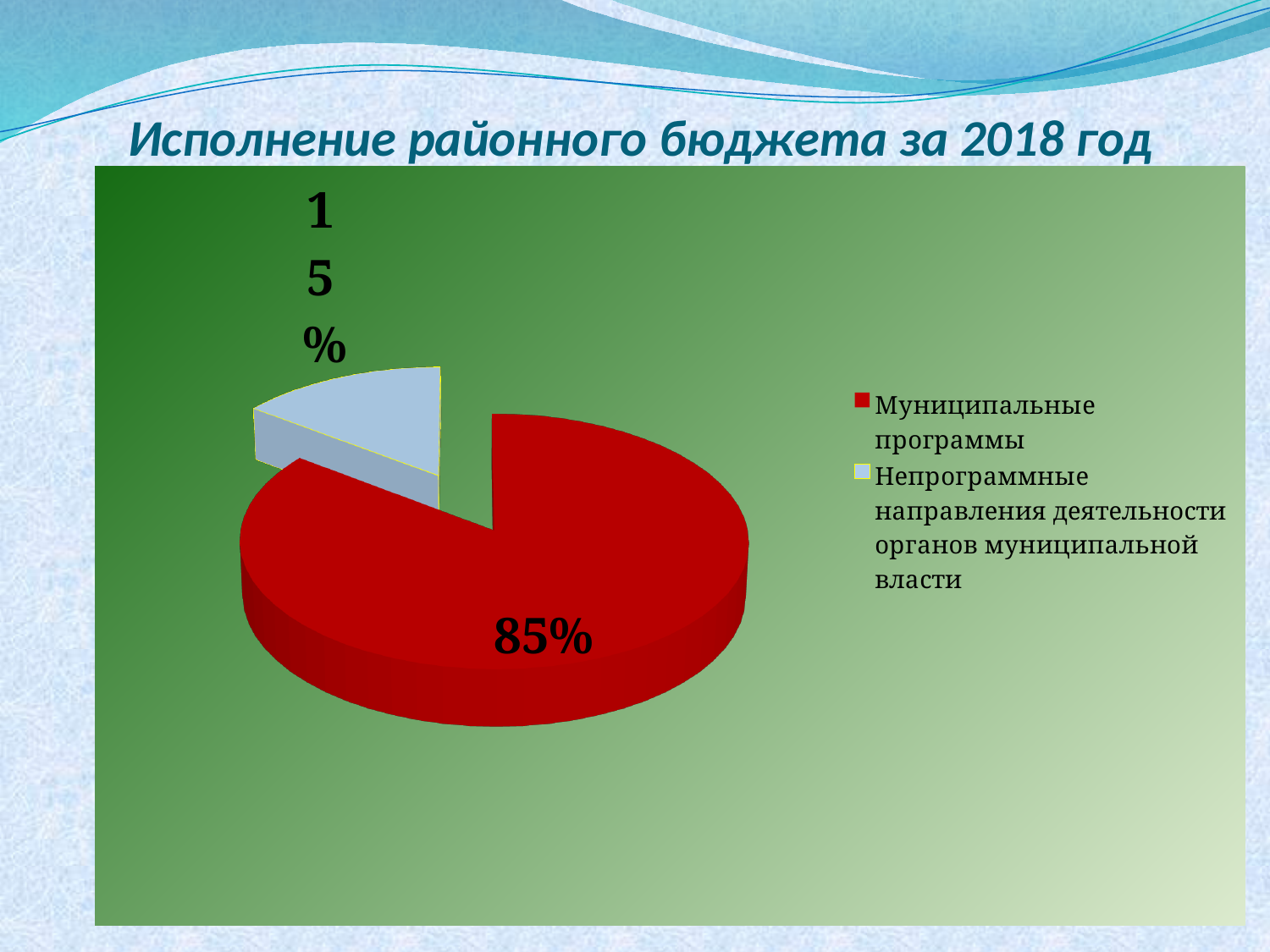
Which category has the smallest slice of the pie? Непрограммные направления деятельности органов муниципальной власти What is the difference in percentage points between the Муниципальные программы slice and the Непрограммные направления slice? 70 Which category has the largest slice of the pie? Муниципальные программы How many slices does the pie chart have? 2 What kind of chart is shown on the slide? pie chart What share of the pie is labelled for Непрограммные направления деятельности органов муниципальной власти? 15% What colour is the slice for Муниципальные программы? red Which is larger: the slice for Муниципальные программы or the slice for Непрограммные направления деятельности органов муниципальной власти? Муниципальные программы How many entries does the legend list? 2 What is the title of the slide containing the chart? Исполнение районного бюджета за 2018 год What share of the pie is labelled for Муниципальные программы? 85%